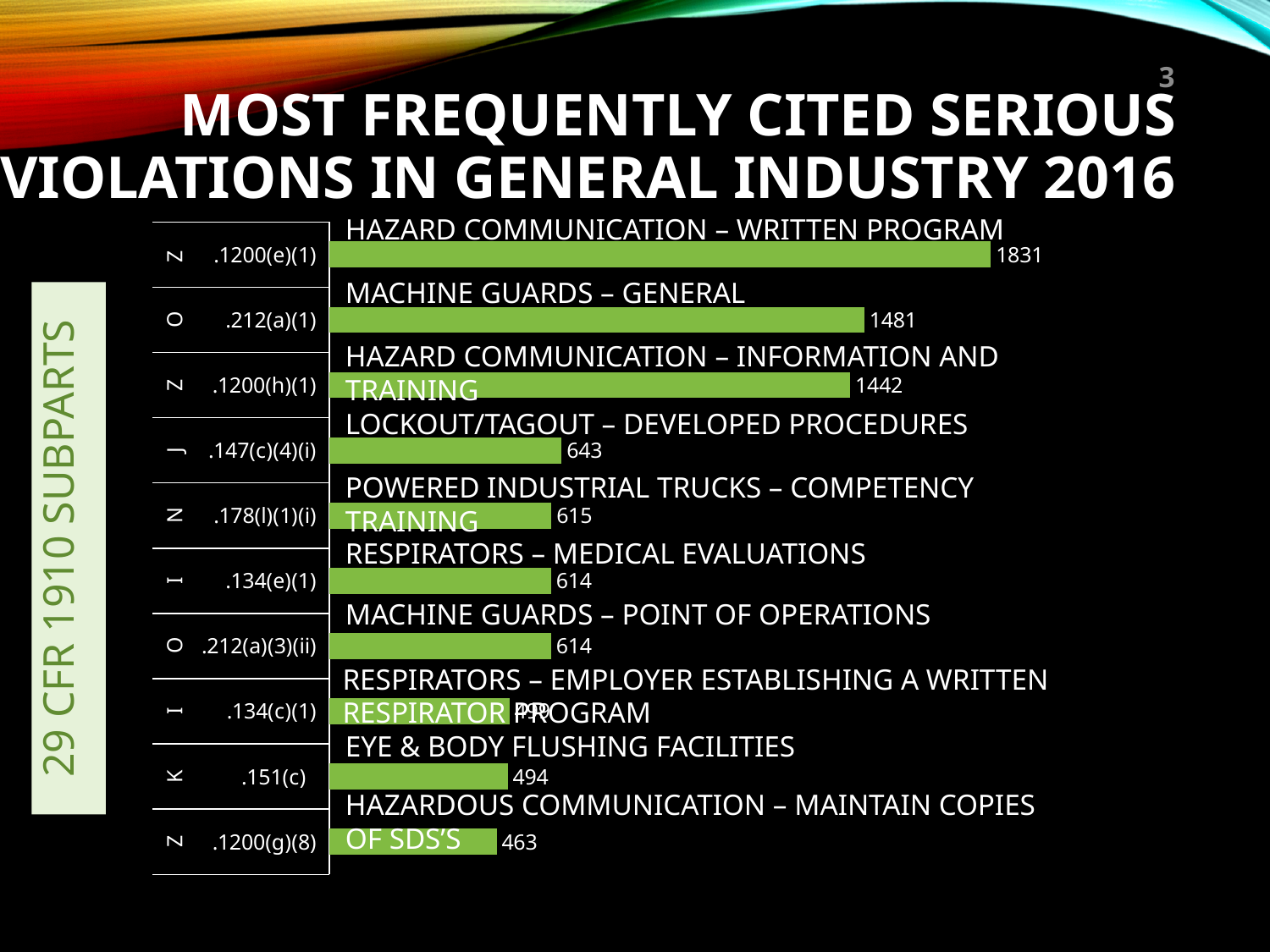
What is the value for .212(a)(1), Machine Guards – General? 1481 Which category has the lowest value? .1200(g)(8) Hazardous Communication – Maintain Copies of SDS's What is the value for .147(c)(4)(i), Lockout/Tagout – Developed Procedures? 643 What is the difference between the values for .1200(e)(1) and .212(a)(1)? 350 Which has a larger value, .212(a)(1) Machine Guards – General or .178(l)(1)(i) Powered Industrial Trucks – Competency Training? .212(a)(1) Machine Guards – General How many violation categories are plotted in the chart? 10 Do the values rise or fall going from the top bar to the bottom bar? fall Which category has the highest value? .1200(e)(1) Hazard Communication – Written Program What is the difference between the values for .1200(h)(1) and .147(c)(4)(i)? 799 What type of chart is shown on the slide? bar chart What is the value for .151(c), Eye & Body Flushing Facilities? 494 What is the value for .1200(e)(1), Hazard Communication – Written Program? 1831